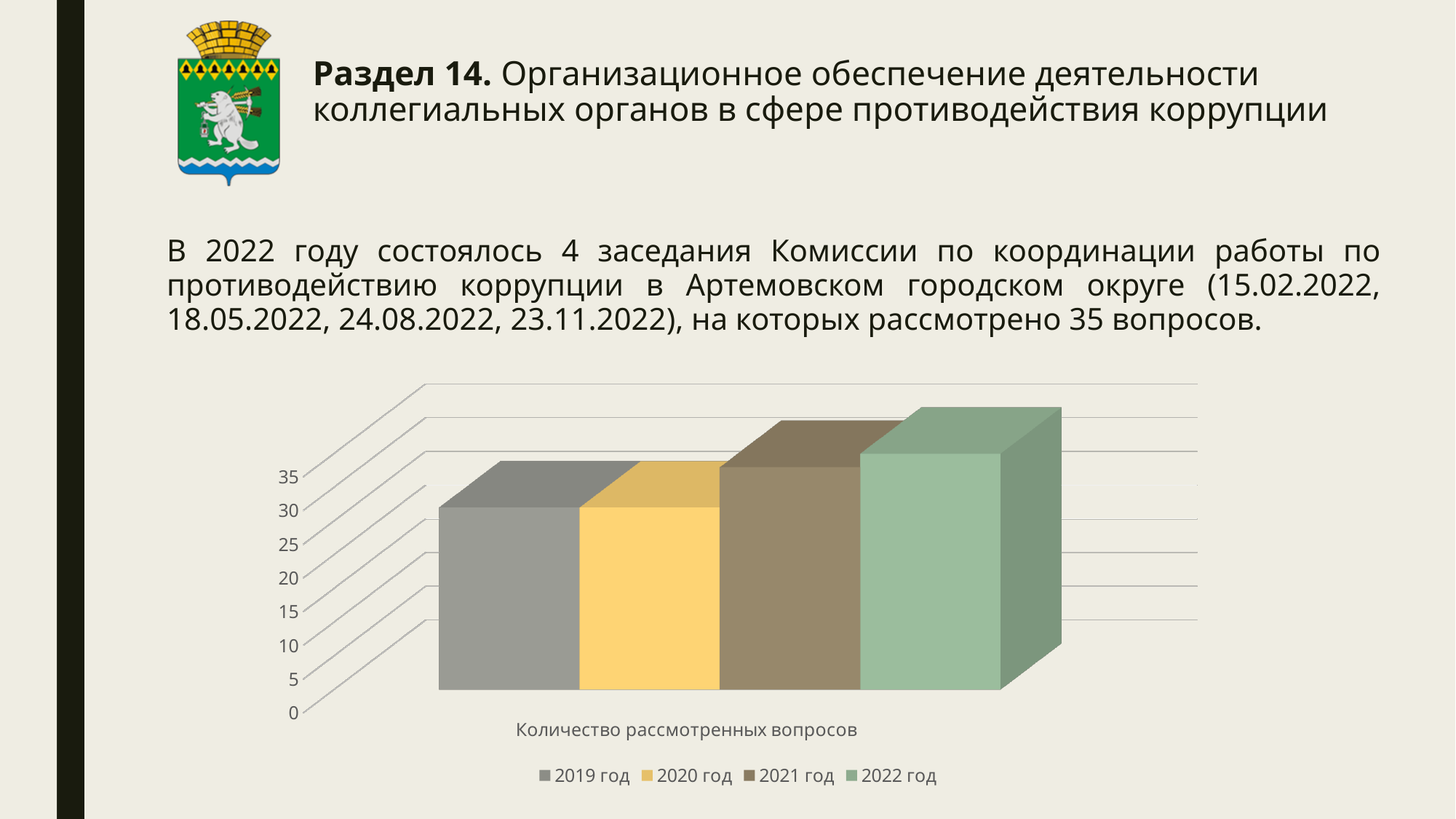
Which is larger in the chart: the bar for 2021 год or the bar for 2020 год? 2021 год How many series does the chart legend list? 4 What kind of chart is shown on the slide? bar chart How many categories are shown on the x axis of the chart? 1 Which series has the highest bar in the chart? 2022 год Is the value for 2019 год greater or less than 10? greater Is the value for 2022 год greater or less than 20? greater What is the category label shown on the x axis of the chart? Количество рассмотренных вопросов Which series is shown in yellow in the chart? 2020 год Which is larger in the chart: the bar for 2022 год or the bar for 2019 год? 2022 год